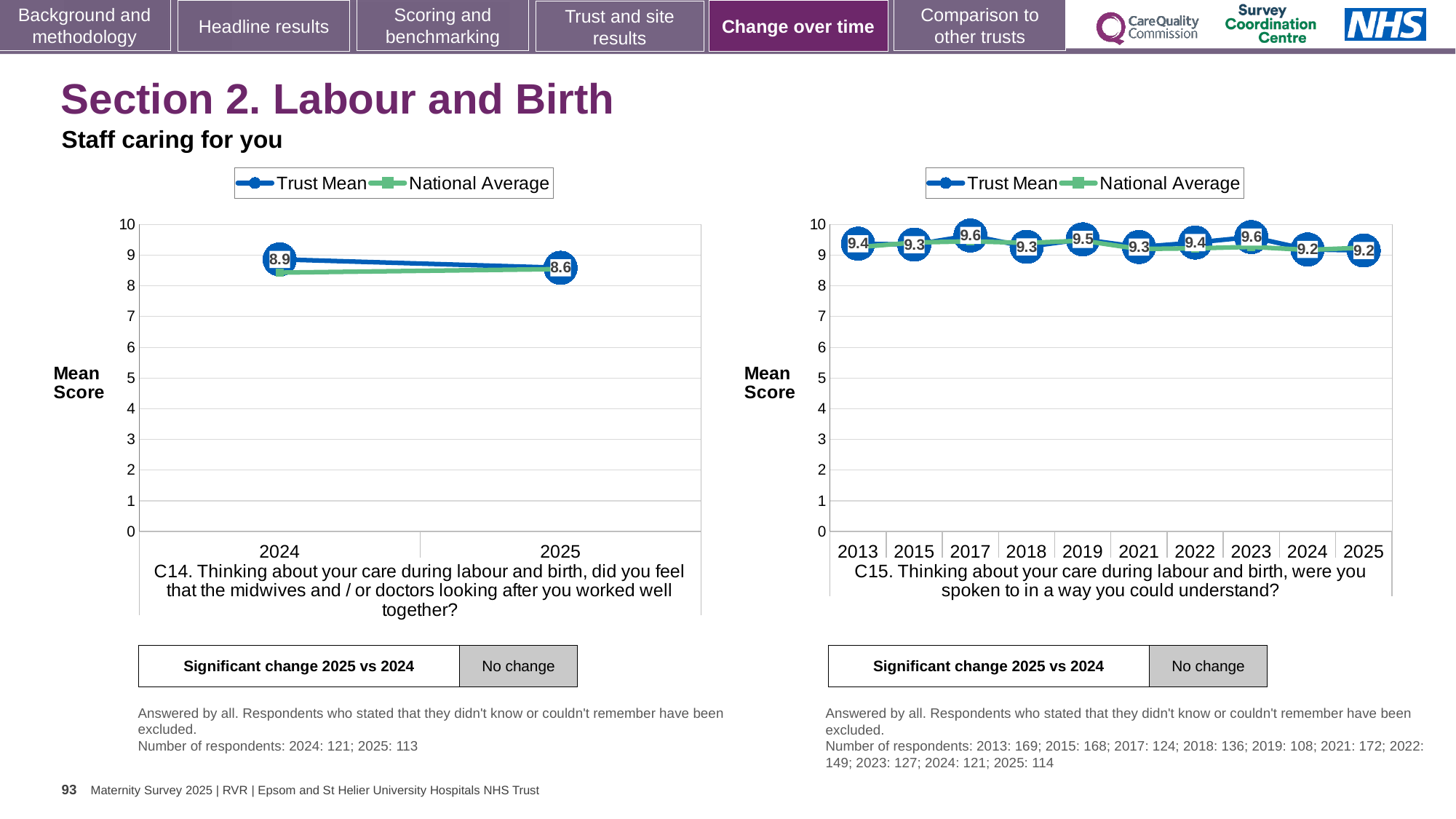
What type of chart is the C15 chart on the right? line chart In the C14 chart on the left, how many series does the legend list? 2 In the C15 chart on the right, what is the Trust Mean for 2013? 9.4 In the C15 chart on the right, what is the Trust Mean for 2019? 9.5 In the C14 chart on the left, by how much did the Trust Mean fall from 2024 to 2025? 0.3 In the C15 chart on the right, how many years are plotted on the x axis? 10 In the C14 chart on the left, what is the Trust Mean for 2025? 8.6 In the C15 chart on the right, what is the difference between the Trust Mean for 2023 and for 2024? 0.4 In the C15 chart on the right, what is the Trust Mean for 2025? 9.2 In the C15 chart on the right, which is larger, the Trust Mean for 2017 or for 2018? 2017 In the C14 chart on the left, what is the Trust Mean for 2024? 8.9 In the C14 chart on the left, does the Trust Mean rise or fall from 2024 to 2025? fall